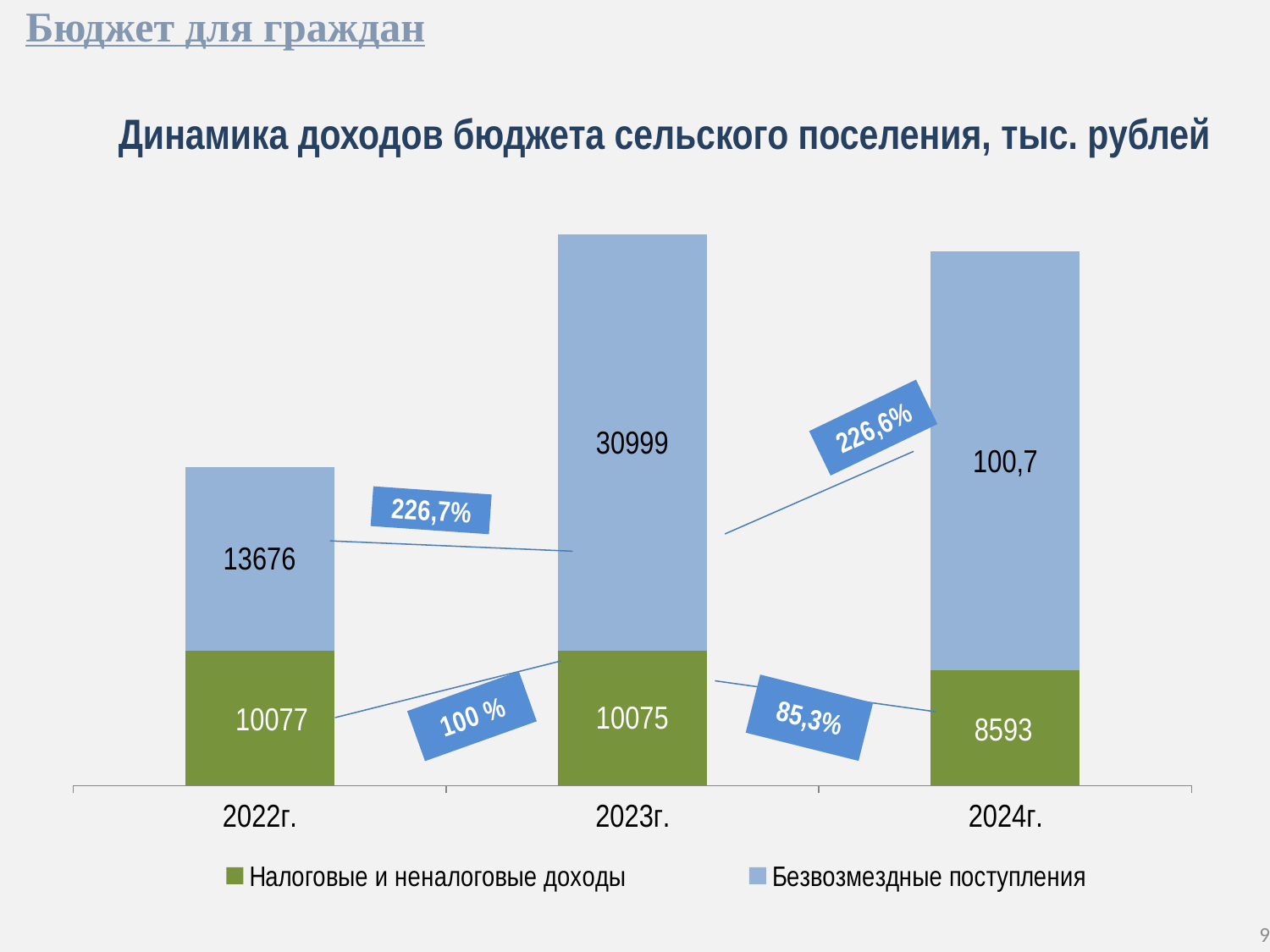
What is the value of Безвозмездные поступления for 2022г.? 13676 What is the value of Налоговые и неналоговые доходы for 2024г.? 8593 How many series does the legend list? 2 What is the value of Налоговые и неналоговые доходы for 2022г.? 10077 What is the value of Безвозмездные поступления for 2023г.? 30999 Is the value of Безвозмездные поступления larger in 2022г. or in 2023г.? 2023г. What is the difference between Безвозмездные поступления and Налоговые и неналоговые доходы in 2023г.? 20924 What kind of chart is shown on the slide? Stacked bar chart What is the total of the stacked bar for 2022г.? 23753 Which year has the lowest value of Налоговые и неналоговые доходы? 2024г. How many years are shown on the x axis? 3